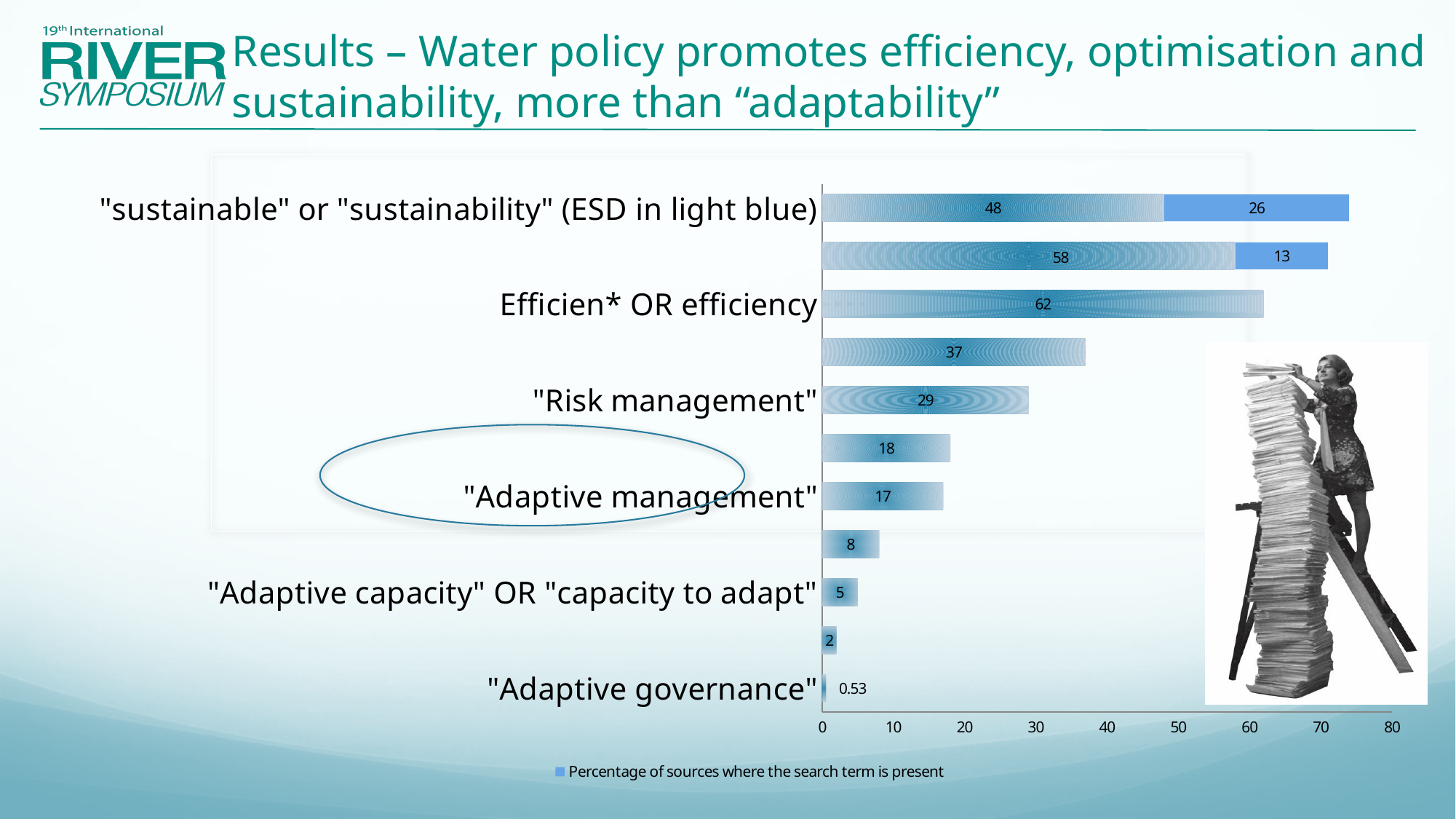
What is the difference between the values for "Efficien* OR efficiency" and "Risk management"? 33 What is the value for "Adaptive governance"? 0.53 What is the dark-blue value for "sustainable" or "sustainability"? 48 What is the value for "Efficien* OR efficiency"? 62 How many series does the legend list? 1 What kind of chart is shown on the slide? bar chart Which is larger, the value for "Risk management" or for "Adaptive management"? "Risk management" Which labelled category has the lowest value? "Adaptive governance" What is the value for "Risk management"? 29 What does the legend say the bars represent? Percentage of sources where the search term is present What is the value for "Adaptive management"? 17 What is the total of the stacked bar for "sustainable" or "sustainability" (48 plus the light-blue ESD segment)? 74